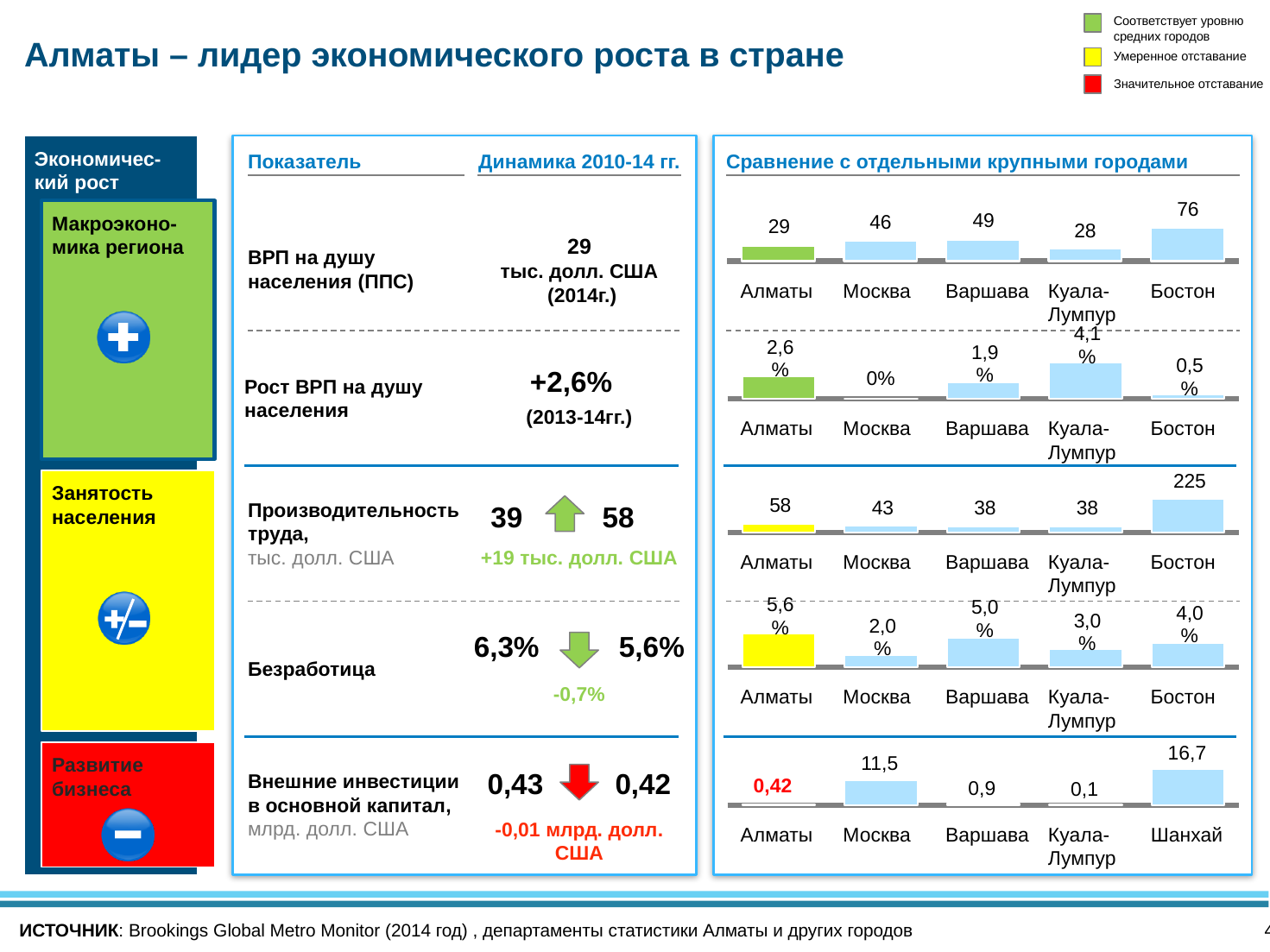
In the fourth chart from the top of the right panel (unemployment comparison), what is the value for Москва? 2,0 % In the top chart of the right panel (GRP per capita comparison), what is the value for Бостон? 76 In the third chart from the top of the right panel (labour productivity comparison), what is the value for Москва? 43 In the top chart of the right panel (GRP per capita comparison), what is the difference between Бостон and Алматы? 47 In the top chart of the right panel (GRP per capita comparison), which city has the lowest value? Куала-Лумпур In the bottom chart of the right panel (external investment comparison), how many cities are shown? 5 In the second chart from the top of the right panel (GRP growth comparison), which city has the lowest value? Москва In the second chart from the top of the right panel (GRP growth comparison), what is the value for Куала-Лумпур? 4,1 % In the fourth chart from the top of the right panel (unemployment comparison), which is larger, Алматы or Варшава? Алматы In the bottom chart of the right panel (external investment comparison), what is the value for Шанхай? 16,7 In the third chart from the top of the right panel (labour productivity comparison), which city has the highest value? Бостон What type of chart is used in the right panel to compare cities? Bar chart